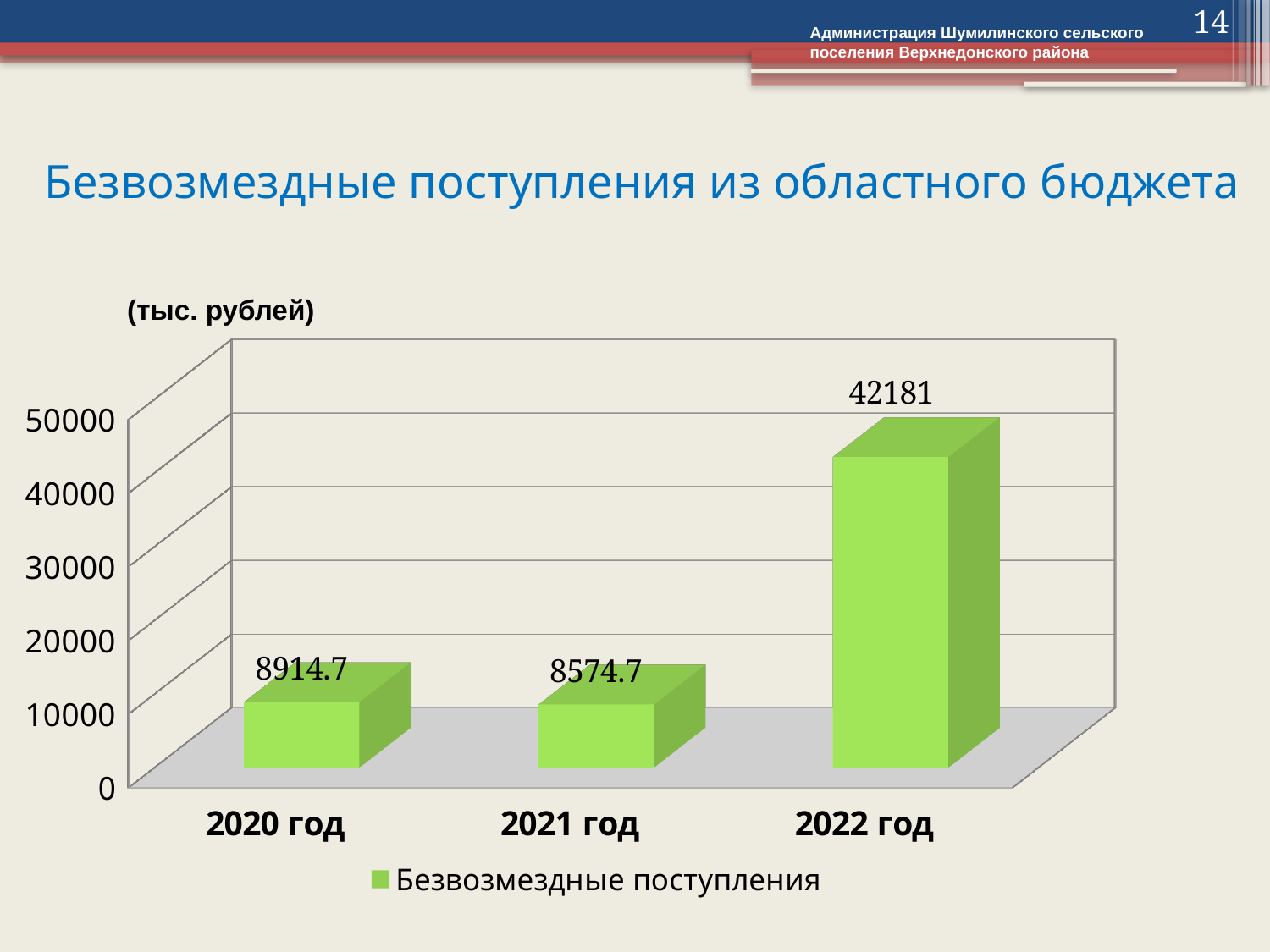
What is the value for 2021 год? 8574.7 How many years are shown on the x axis? 3 Which year has the lowest value? 2021 год Which year has the highest value? 2022 год Is the value for 2022 год greater or less than 40000? greater What is the difference between the values for 2020 год and 2021 год? 340 What is the name of the series listed in the legend? Безвозмездные поступления Which is larger, the value for 2020 год or 2021 год? 2020 год What is the value for 2022 год? 42181 What is the difference between the values for 2022 год and 2020 год? 33266.3 What is the value for 2020 год? 8914.7 What kind of chart is shown on the slide? bar chart